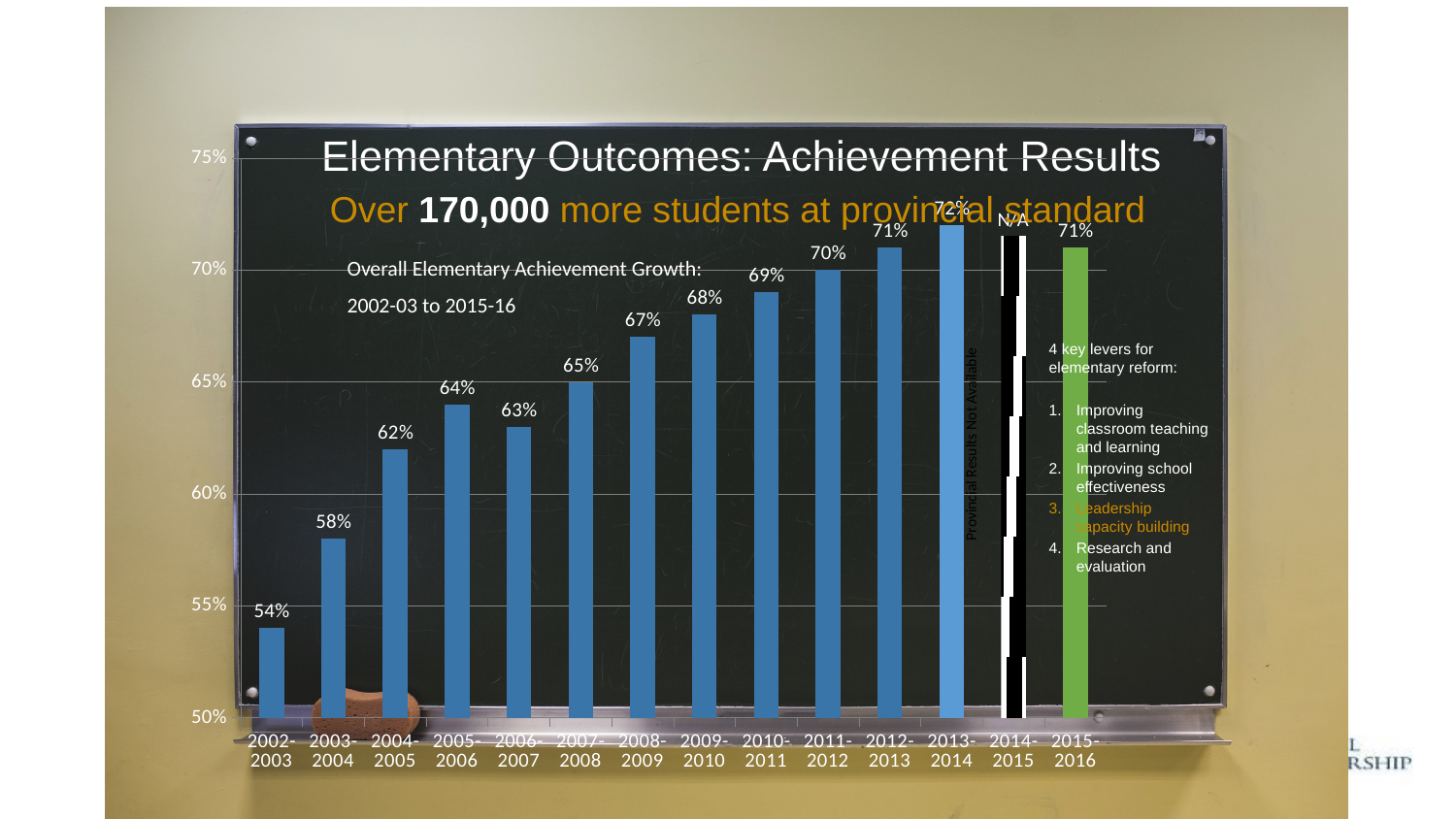
What is the value for 2006-2007? 63% How many year categories are shown on the x axis? 14 What label is shown for 2014-2015 instead of a percentage? N/A Is the value for 2004-2005 greater or less than 60%? greater What is the value for 2009-2010? 68% Which year has the lowest value? 2002-2003 What is the difference between the values for 2015-2016 and 2002-2003? 17% Do the values generally rise or fall from 2002-2003 to 2013-2014? rise What kind of chart is shown on the slide? bar chart Which is larger, the value for 2005-2006 or the value for 2006-2007? 2005-2006 What is the value for 2002-2003? 54% What is the value for 2015-2016? 71%